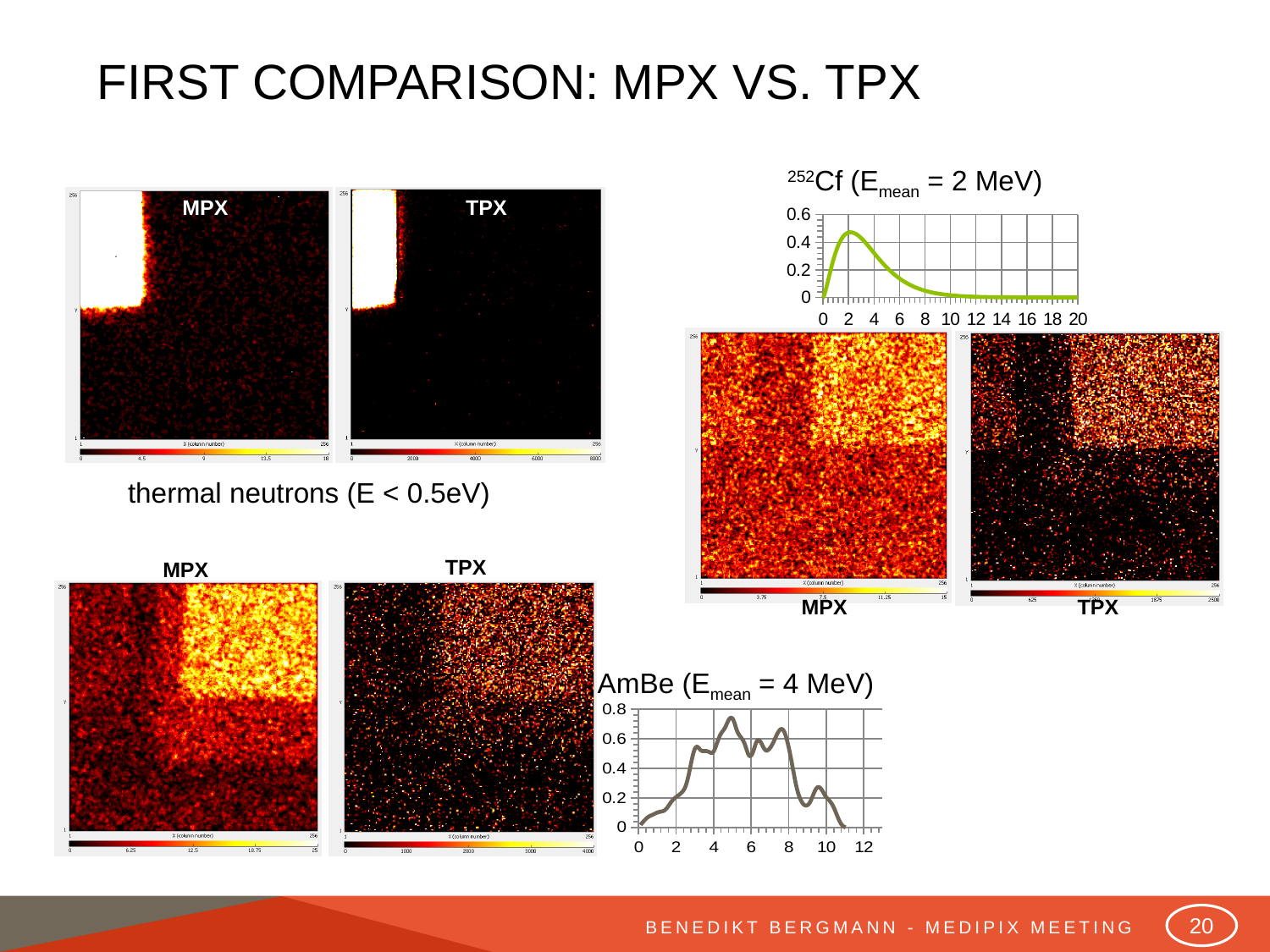
What kind of chart is the AmBe (Emean = 4 MeV) chart? line chart In the AmBe (Emean = 4 MeV) chart, is the value at x = 5 greater or less than 0.6? greater In the 252Cf (Emean = 2 MeV) chart, do the values rise or fall as x increases from 4 to 20? fall Which chart has the higher maximum y-axis tick, the 252Cf chart or the AmBe chart? AmBe chart In the 252Cf (Emean = 2 MeV) chart, is the value at x = 10 greater or less than 0.2? less In the AmBe (Emean = 4 MeV) chart, is the value at x = 1 greater or less than 0.2? less What colour is the line in the 252Cf (Emean = 2 MeV) chart? green What kind of chart is the 252Cf (Emean = 2 MeV) chart? line chart How many x-axis tick labels are shown on the AmBe (Emean = 4 MeV) chart? 7 What is the largest x-axis tick label on the 252Cf (Emean = 2 MeV) chart? 20